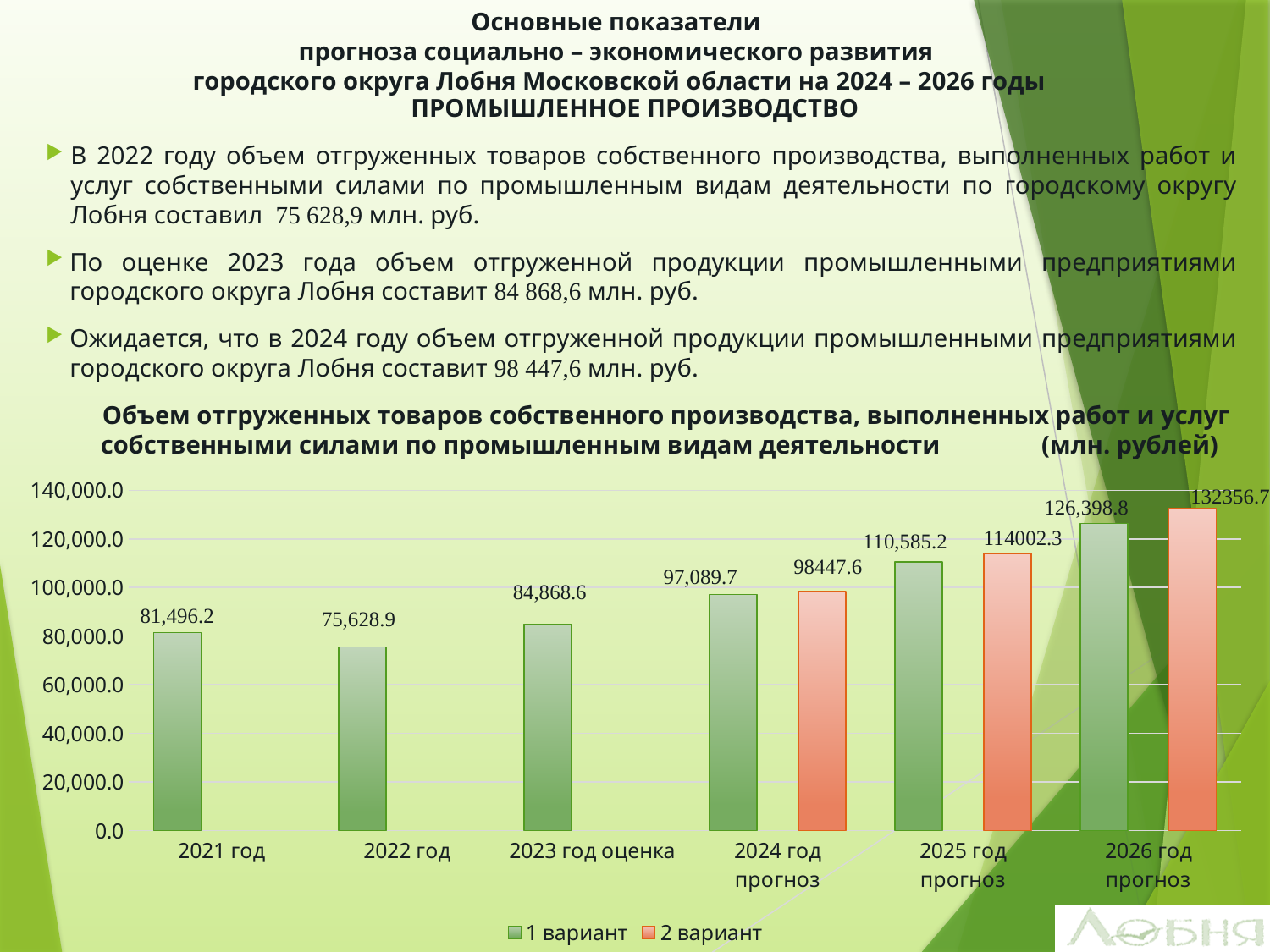
What is the value of "2 вариант" for 2025 год прогноз? 114002.3 How many series does the chart legend list? 2 What type of chart is shown on the slide? bar chart What is the difference between "2 вариант" and "1 вариант" for 2024 год прогноз? 1,357.9 Which year has the highest value for "2 вариант"? 2026 год прогноз How many year categories are shown on the x axis of the chart? 6 Is the value of "1 вариант" for 2025 год прогноз greater or less than 100,000.0? greater What is the value of "1 вариант" for 2021 год? 81,496.2 Which year has the lowest value for "1 вариант"? 2022 год What is the value of "1 вариант" for 2023 год оценка? 84,868.6 For 2026 год прогноз, which is larger: "1 вариант" or "2 вариант"? 2 вариант From 2022 год to 2026 год прогноз, do the values of "1 вариант" rise or fall? rise